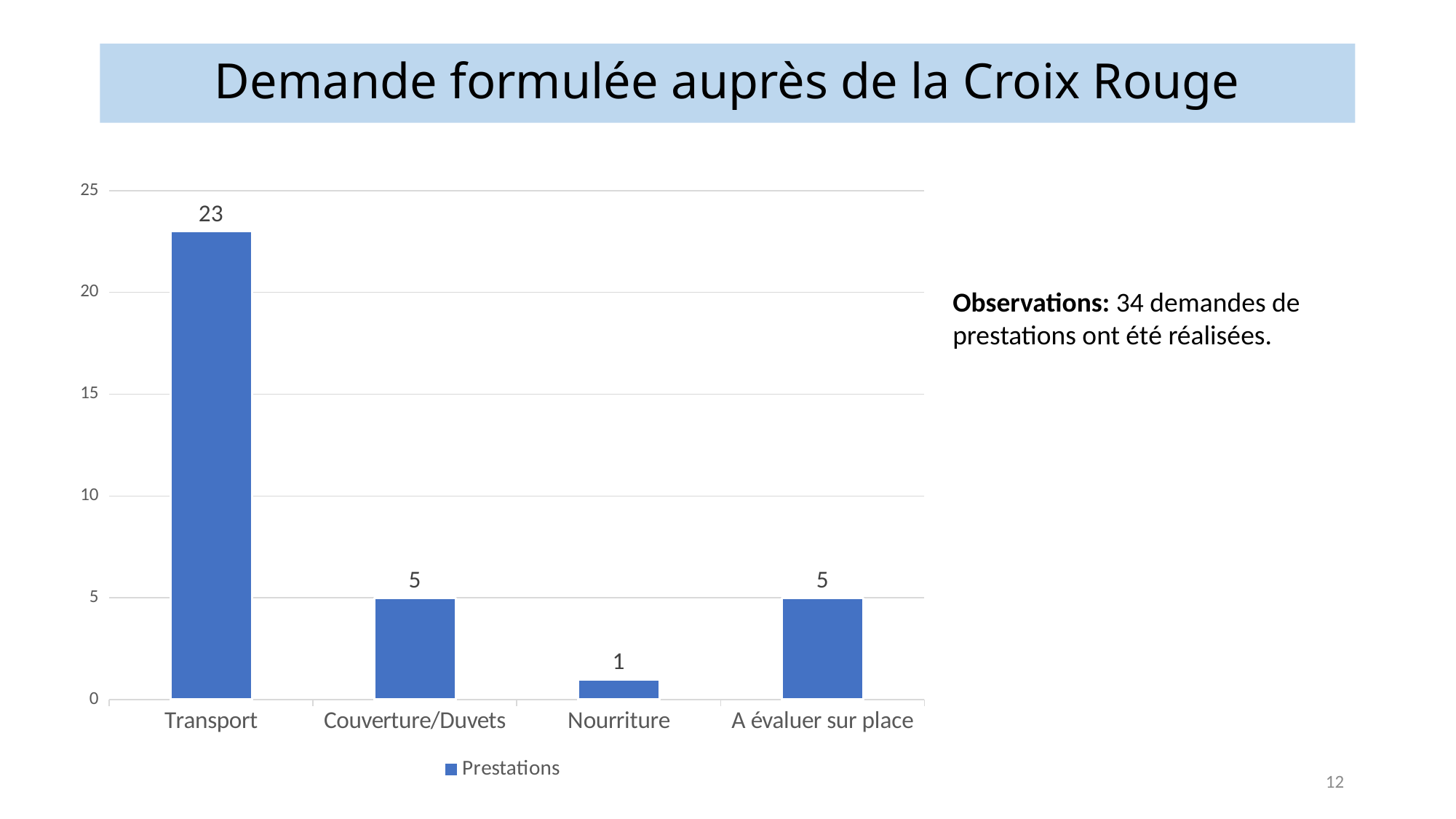
What is the value for Nourriture? 1 What is the value for A évaluer sur place? 5 What is the value for Transport? 23 Which is larger, the value for Nourriture or the value for A évaluer sur place? A évaluer sur place What is the difference between the values for Transport and Couverture/Duvets? 18 Which category has the highest value? Transport What is the value for Couverture/Duvets? 5 How many series does the legend list? 1 How many categories are shown on the x axis? 4 Is the value for Transport greater or less than 20? greater Which category has the lowest value? Nourriture What kind of chart is shown on the slide? bar chart